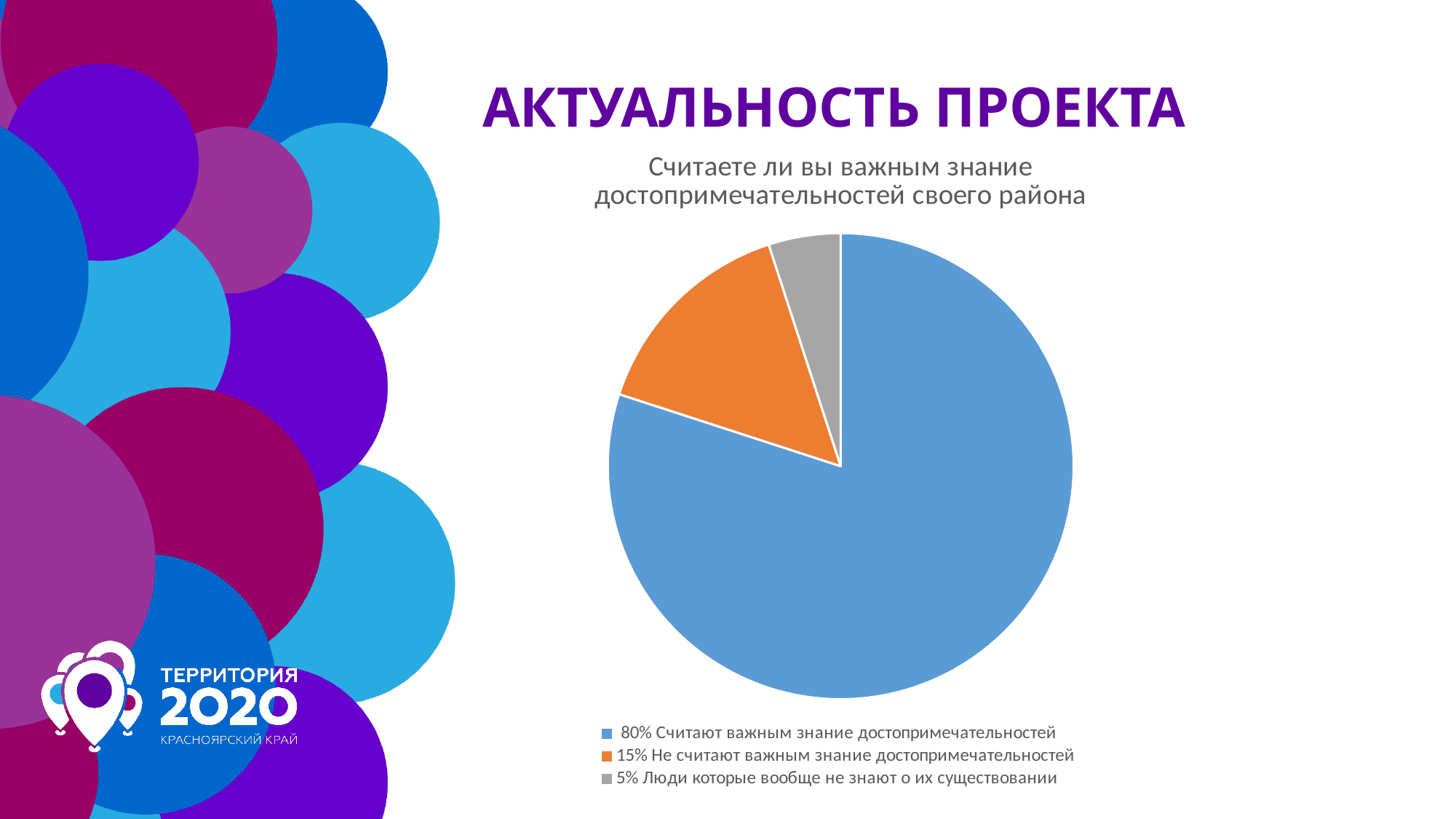
What kind of chart is shown on the slide? pie chart What share of the pie is 'Люди которые вообще не знают о их существовании'? 5% What is the title of the pie chart? Считаете ли вы важным знание достопримечательностей своего района What share of the pie is 'Считают важным знание достопримечательностей'? 80% How many slices does the pie chart have? 3 Which is larger: the share of 'Не считают важным знание достопримечательностей' or 'Люди которые вообще не знают о их существовании'? Не считают важным знание достопримечательностей What is the difference between the share of 'Считают важным знание достопримечательностей' and 'Не считают важным знание достопримечательностей'? 65% What share of the pie is 'Не считают важным знание достопримечательностей'? 15% Which category has the smallest slice of the pie? Люди которые вообще не знают о их существовании What is the difference between the share of 'Не считают важным знание достопримечательностей' and 'Люди которые вообще не знают о их существовании'? 10% What colour is the slice for 'Не считают важным знание достопримечательностей'? orange Which category has the largest slice of the pie? Считают важным знание достопримечательностей